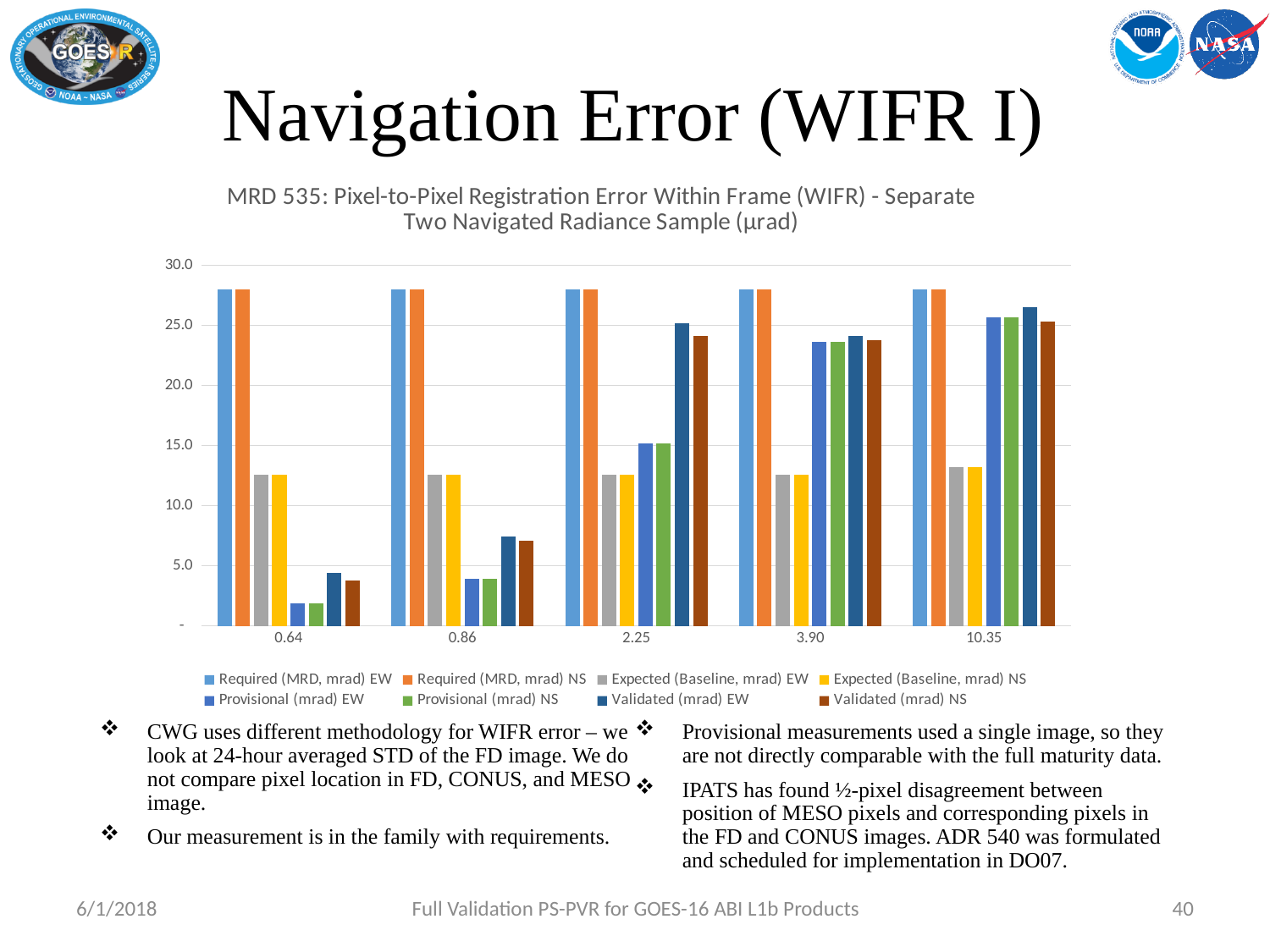
Is the value for Provisional (mrad) EW at 2.25 greater or less than 10.0? greater Is the value for Validated (mrad) EW at 0.86 greater or less than 5.0? greater Do the Provisional (mrad) EW values rise or fall from 0.64 to 10.35 along the x axis? rise Is the value for Expected (Baseline, mrad) EW at 0.64 greater or less than 10.0? greater Which category has the highest value for Provisional (mrad) EW? 10.35 What kind of chart is shown on the slide? bar chart At 0.86, which is larger: Validated (mrad) EW or Provisional (mrad) EW? Validated (mrad) EW How many categories are shown along the x axis of the chart? 5 Which category has the lowest value for Validated (mrad) EW? 0.64 How many series does the chart's legend list? 8